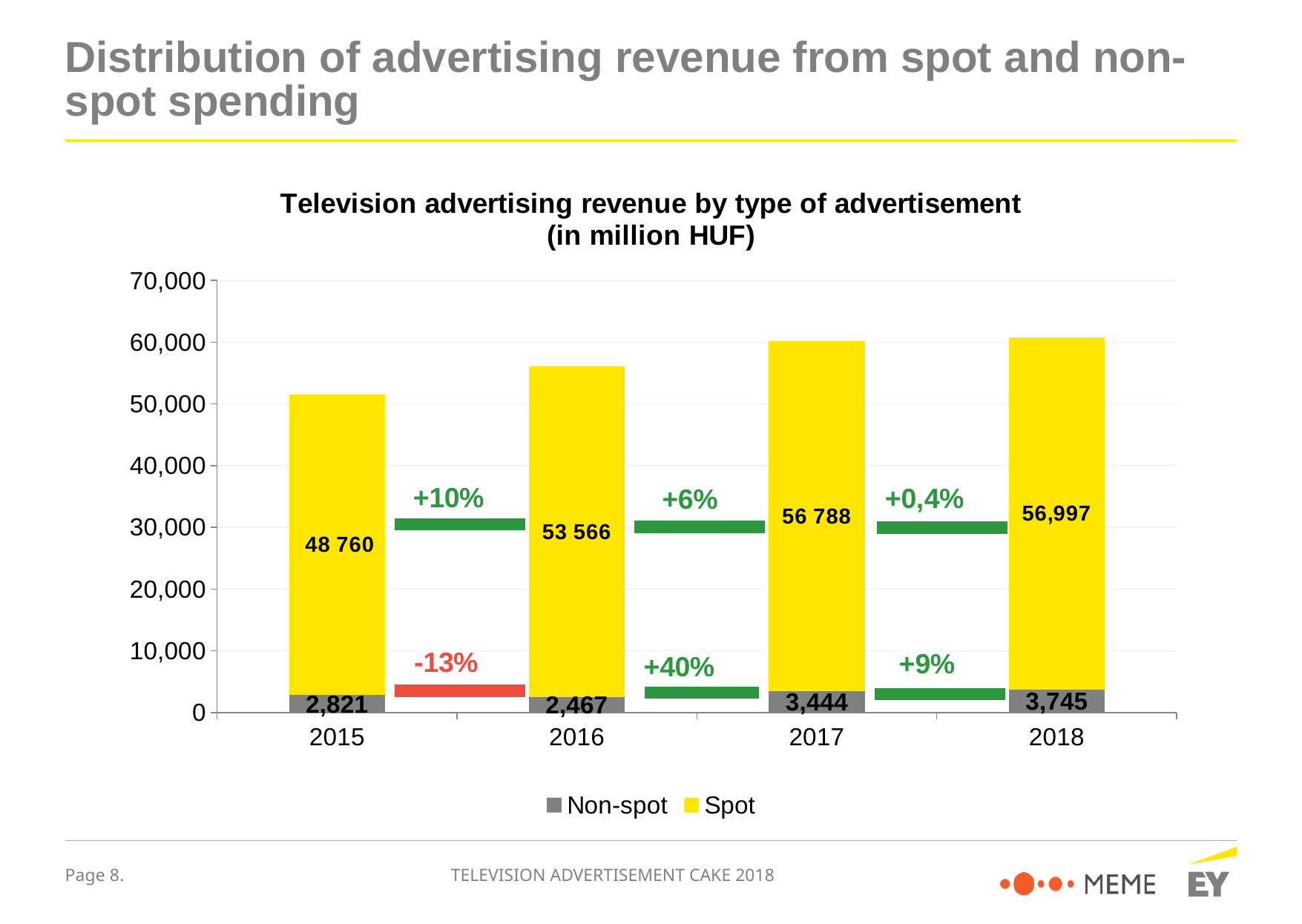
Which year has the lowest Non-spot revenue? 2016 What is the Non-spot revenue for 2017? 3,444 What is the Spot revenue for 2018? 56,997 Which year has the highest Spot revenue? 2018 What is the Spot revenue for 2015? 48 760 How many series does the legend list? 2 What is the total television advertising revenue (Spot plus Non-spot) for 2017? 60,232 What type of chart is shown on the slide? Stacked bar chart Is the Non-spot revenue for 2018 greater or less than the Non-spot revenue for 2015? greater What is the difference between the Spot revenue in 2016 and in 2015? 4,806 What percentage change in Non-spot revenue is shown between 2016 and 2017? +40% How many years are shown on the x axis? 4